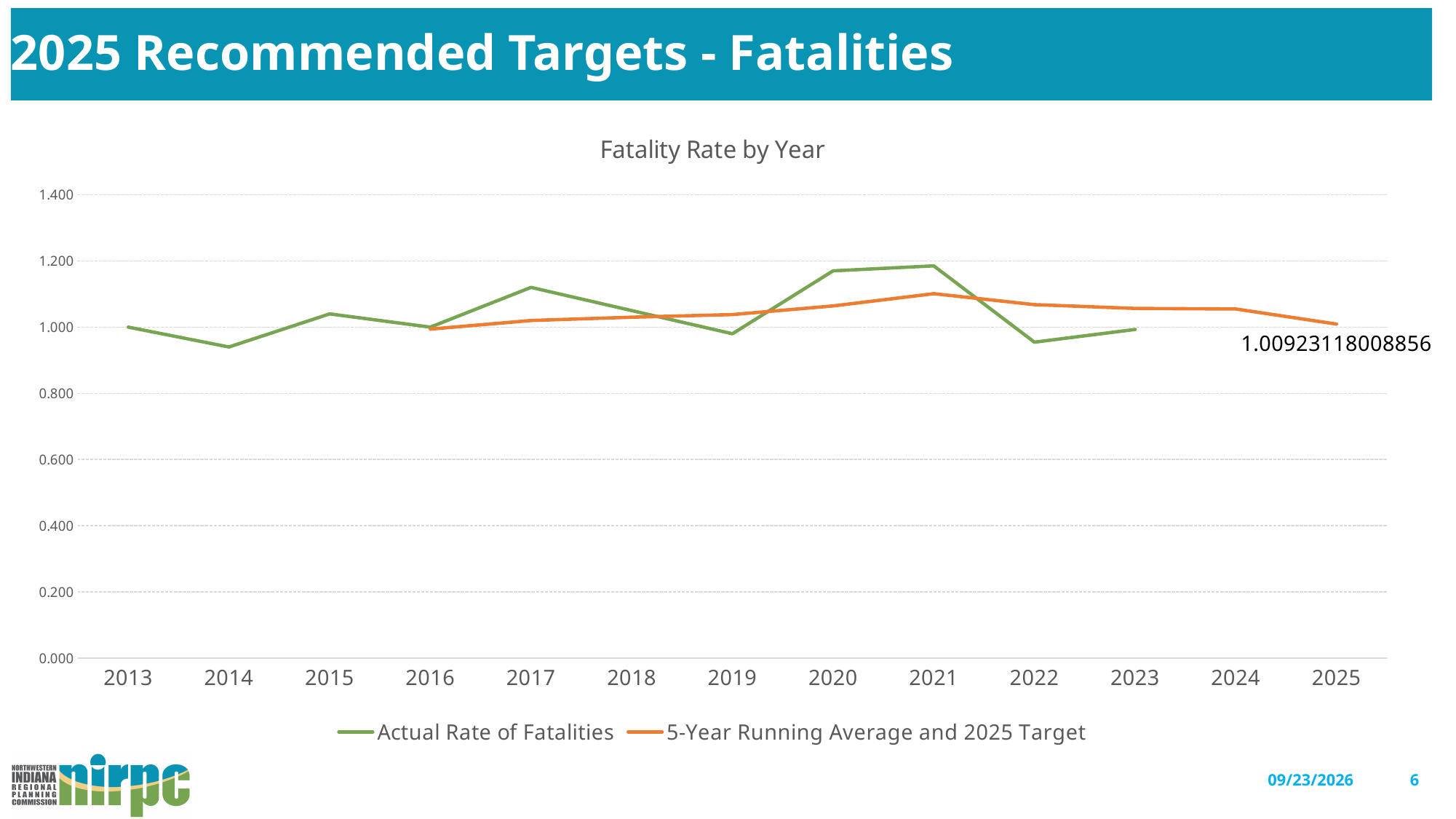
What is the value of the 5-Year Running Average and 2025 Target series in 2025? 1.00923118008856 Is the Actual Rate of Fatalities in 2014 greater or less than 1.000? less What kind of chart is shown on the slide? line chart In 2020, which is larger: the Actual Rate of Fatalities or the 5-Year Running Average and 2025 Target? Actual Rate of Fatalities Is the Actual Rate of Fatalities in 2022 greater or less than 1.000? less How many series does the legend list? 2 Does the 5-Year Running Average and 2025 Target series rise or fall from 2021 to 2025? fall What is the title of the chart? Fatality Rate by Year Is the Actual Rate of Fatalities in 2020 greater or less than 1.000? greater In 2022, which is larger: the Actual Rate of Fatalities or the 5-Year Running Average and 2025 Target? 5-Year Running Average and 2025 Target In which year does the 5-Year Running Average and 2025 Target series reach its highest value? 2021 How many years are shown on the x axis? 13